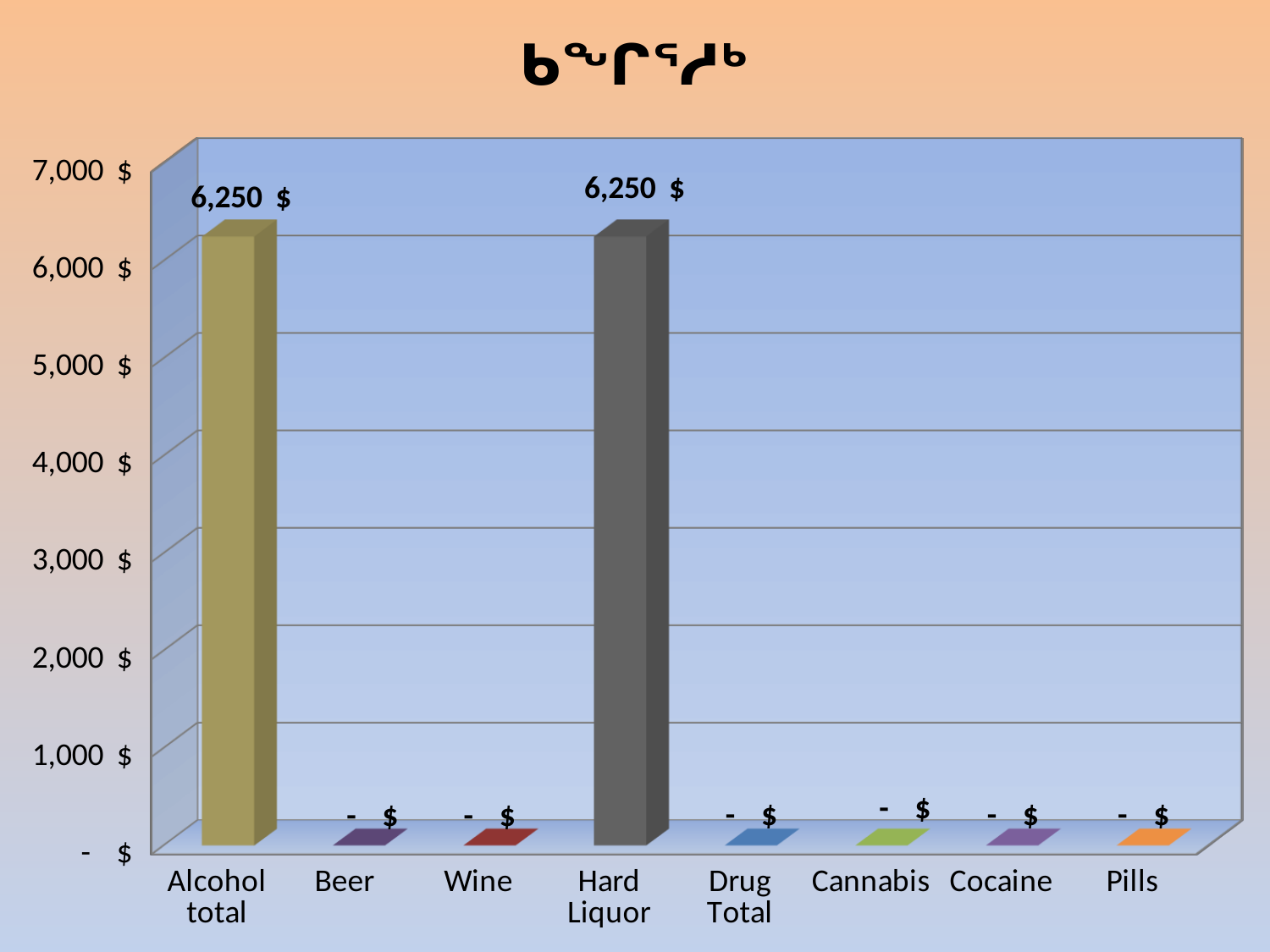
Is the value for Alcohol total greater or less than 7,000 $? less Which two categories share the highest value? Alcohol total and Hard Liquor What kind of chart is this? bar chart Which is larger, the value for Hard Liquor or the value for Cannabis? Hard Liquor What is the highest value shown on the y axis? 7,000 $ What data label is shown for Drug Total? - $ What is the value for Hard Liquor? 6,250 $ What data label is shown for Beer? - $ Which is larger, the value for Alcohol total or the value for Wine? Alcohol total Is the value for Hard Liquor greater or less than 6,000 $? greater How many categories are shown on the x axis? 8 What is the value for Alcohol total? 6,250 $